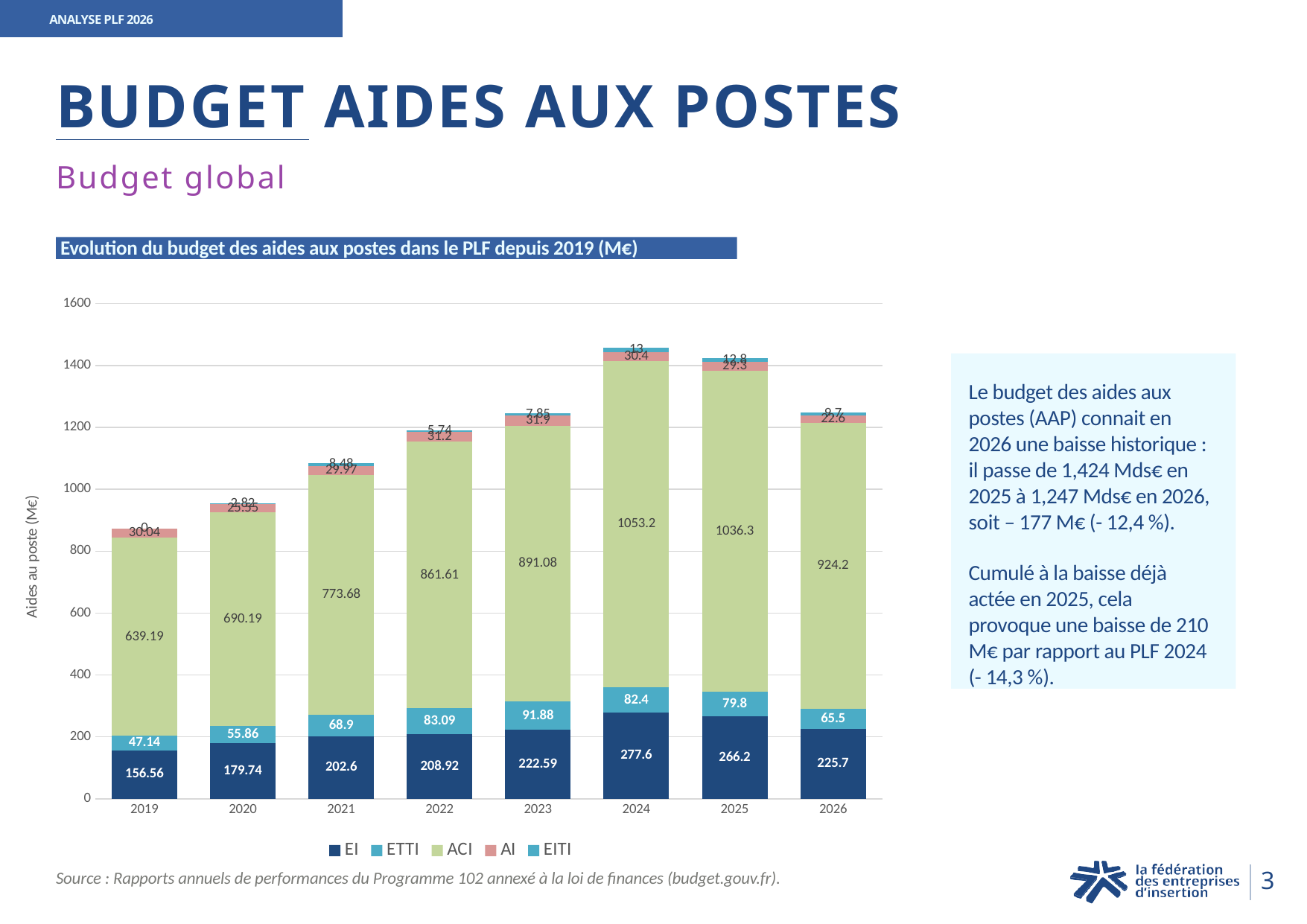
What kind of chart is shown on the slide? Stacked bar chart How many series does the legend list? 5 What is the ETTI value for 2023? 91.88 Which year has the larger ACI value, 2022 or 2023? 2023 How many years are shown on the x axis? 8 Does the ACI value rise or fall from 2019 to 2024? Rise What is the EI value for 2019? 156.56 What is the ACI value for 2024? 1053.2 In which year is the EI value highest? 2024 Is the total stacked value for 2019 greater or less than 1000? less In which year is the ETTI value lowest? 2019 What is the difference between the EI value in 2025 and in 2026? 40.5